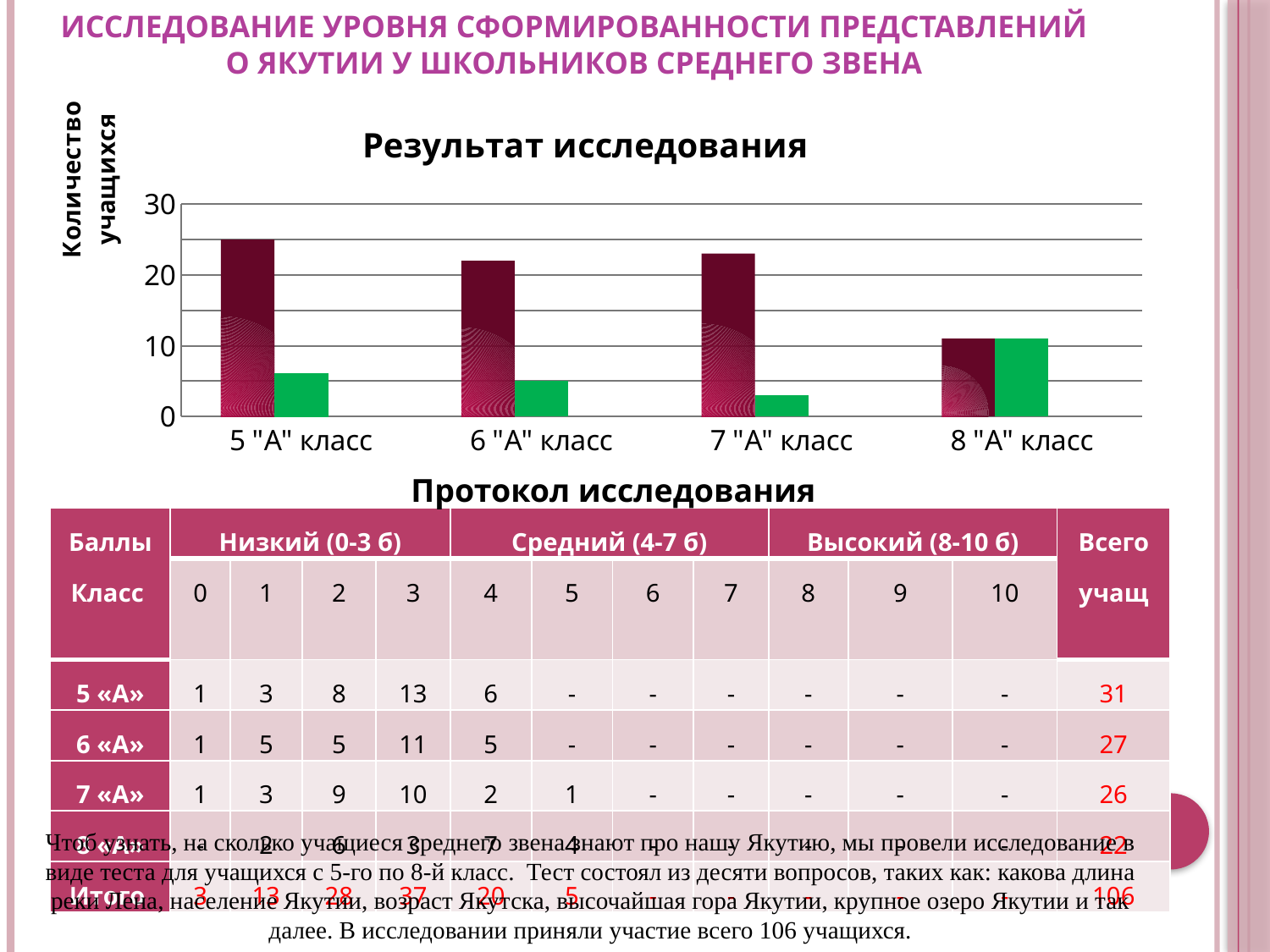
Which class has the tallest dark red bar in the chart? 5 "А" класс What is the label on the vertical axis of the chart? Количество учащихся Is the dark red bar for 5 "А" класс greater or less than 20? greater Is the dark red bar for 7 "А" класс greater or less than 20? greater What kind of chart is shown under the title "Результат исследования"? bar chart How many classes (categories) are shown on the x axis of the chart? 4 Is the green bar for 5 "А" класс greater or less than 10? less Which class has the tallest green bar in the chart? 8 "А" класс What is the title of the chart on the slide? Результат исследования Which class has the shortest dark red bar in the chart? 8 "А" класс Which is larger: the green bar for 8 "А" класс or the green bar for 7 "А" класс? 8 "А" класс Which is larger: the dark red bar for 5 "А" класс or the dark red bar for 8 "А" класс? 5 "А" класс